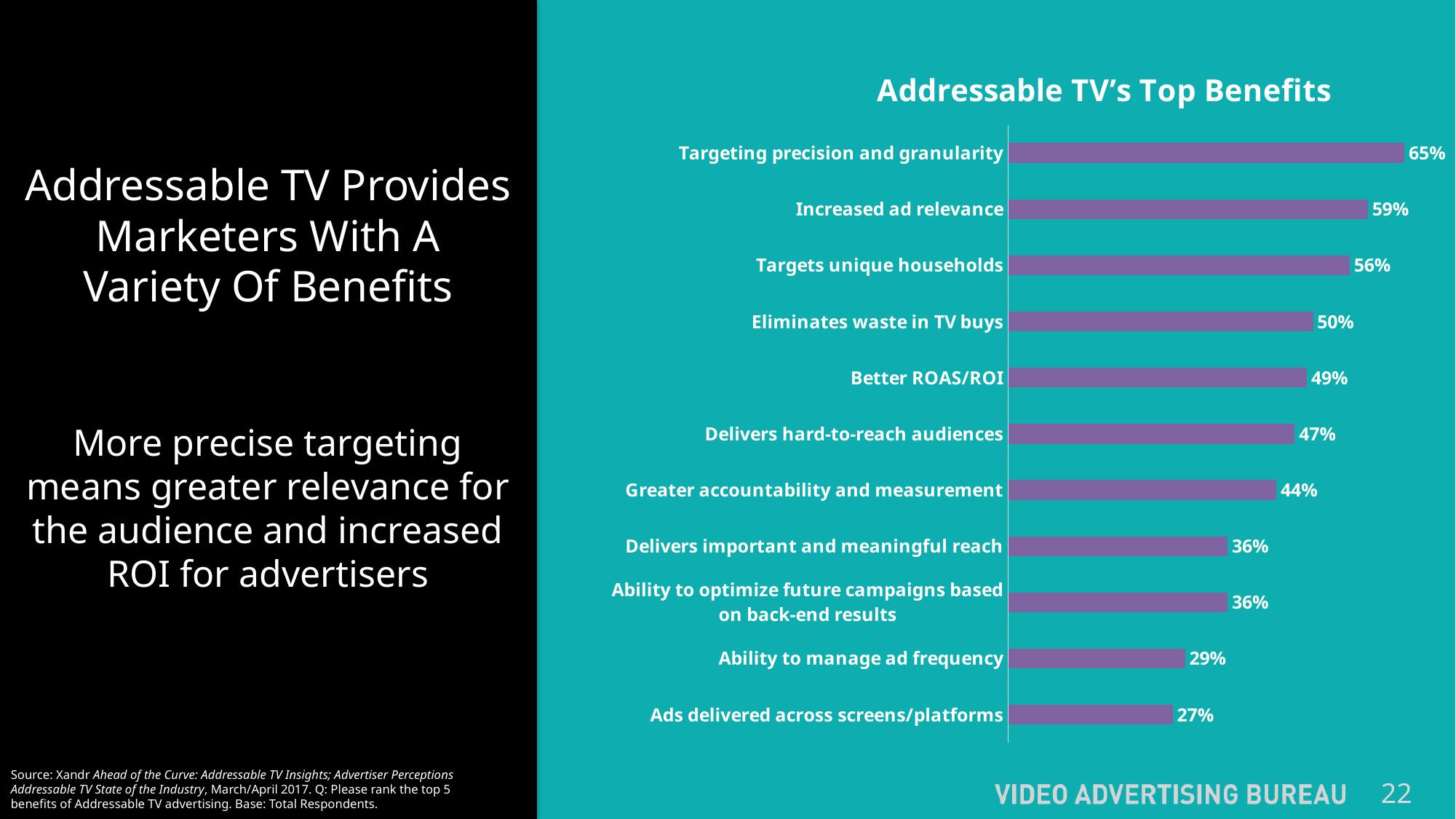
What is the difference between Targeting precision and granularity and Ads delivered across screens/platforms? 38% Which is larger, Better ROAS/ROI or Greater accountability and measurement? Better ROAS/ROI Which benefit has the lowest value? Ads delivered across screens/platforms What is the difference between Increased ad relevance and Targets unique households? 3% What kind of chart is shown on the slide? Bar chart How many benefits are shown in the chart? 11 What is the value for Ability to manage ad frequency? 29% What colour are the bars in the chart? Purple What is the value for Eliminates waste in TV buys? 50% What is the title of the chart? Addressable TV's Top Benefits Which benefit has the highest value? Targeting precision and granularity What is the value for Targeting precision and granularity? 65%